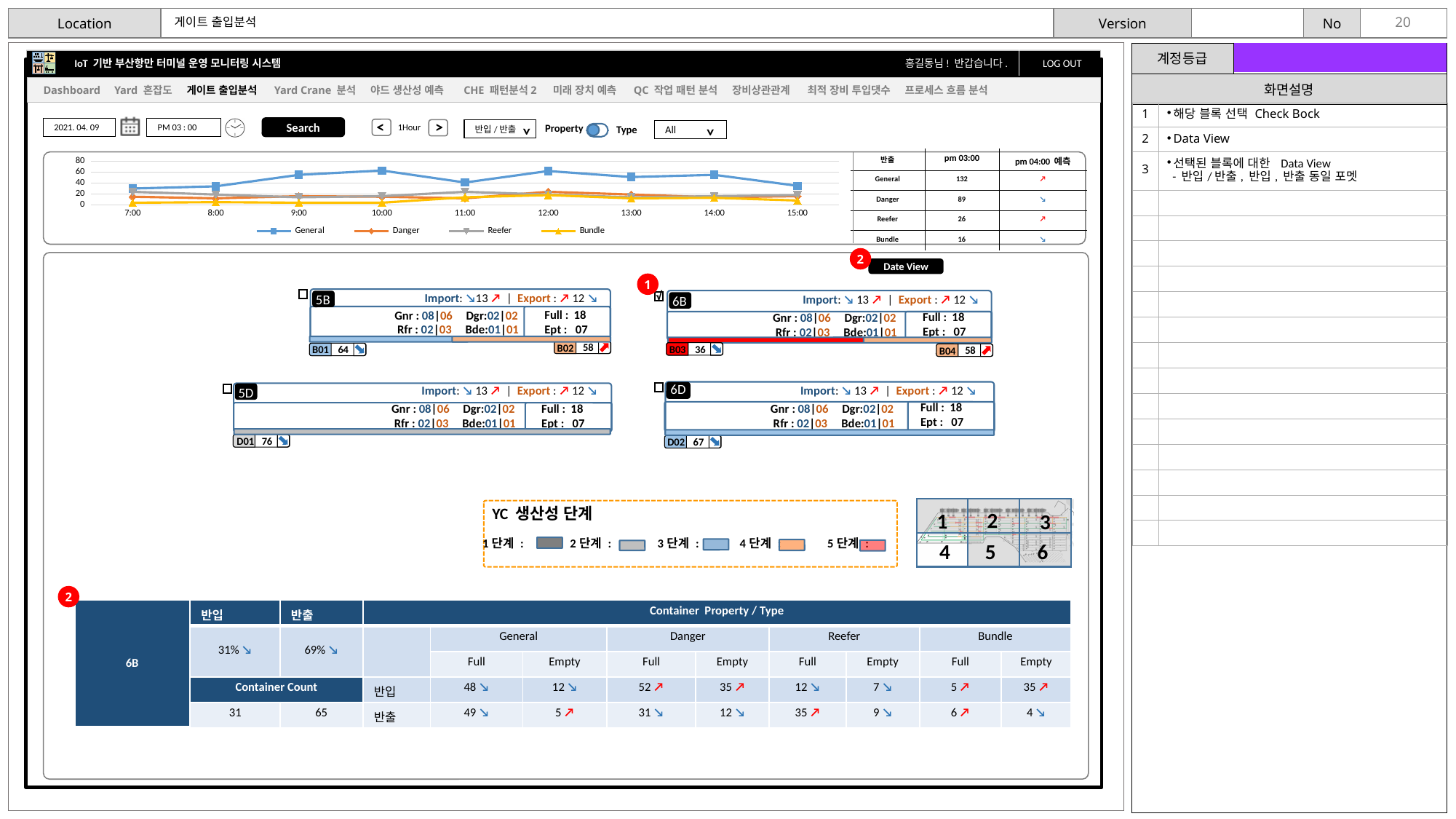
How many time points are plotted along the x axis of the top line chart? 9 In the top line chart, is the value for General at 7:00 greater or less than 40? less What are the legend entries of the top line chart? General, Danger, Reefer, Bundle In the top line chart, is the value for Danger at 12:00 greater or less than 40? less In the top line chart, is the value for General at 10:00 greater or less than 40? greater In the top line chart, does the General series rise or fall from 14:00 to 15:00? fall In the top line chart, does the General series rise or fall from 7:00 to 10:00? rise What kind of chart is shown at the top of the slide? line chart Which series has the highest values across the top line chart? General How many series does the legend of the top line chart list? 4 In the top line chart, which is larger at 10:00, General or Danger? General